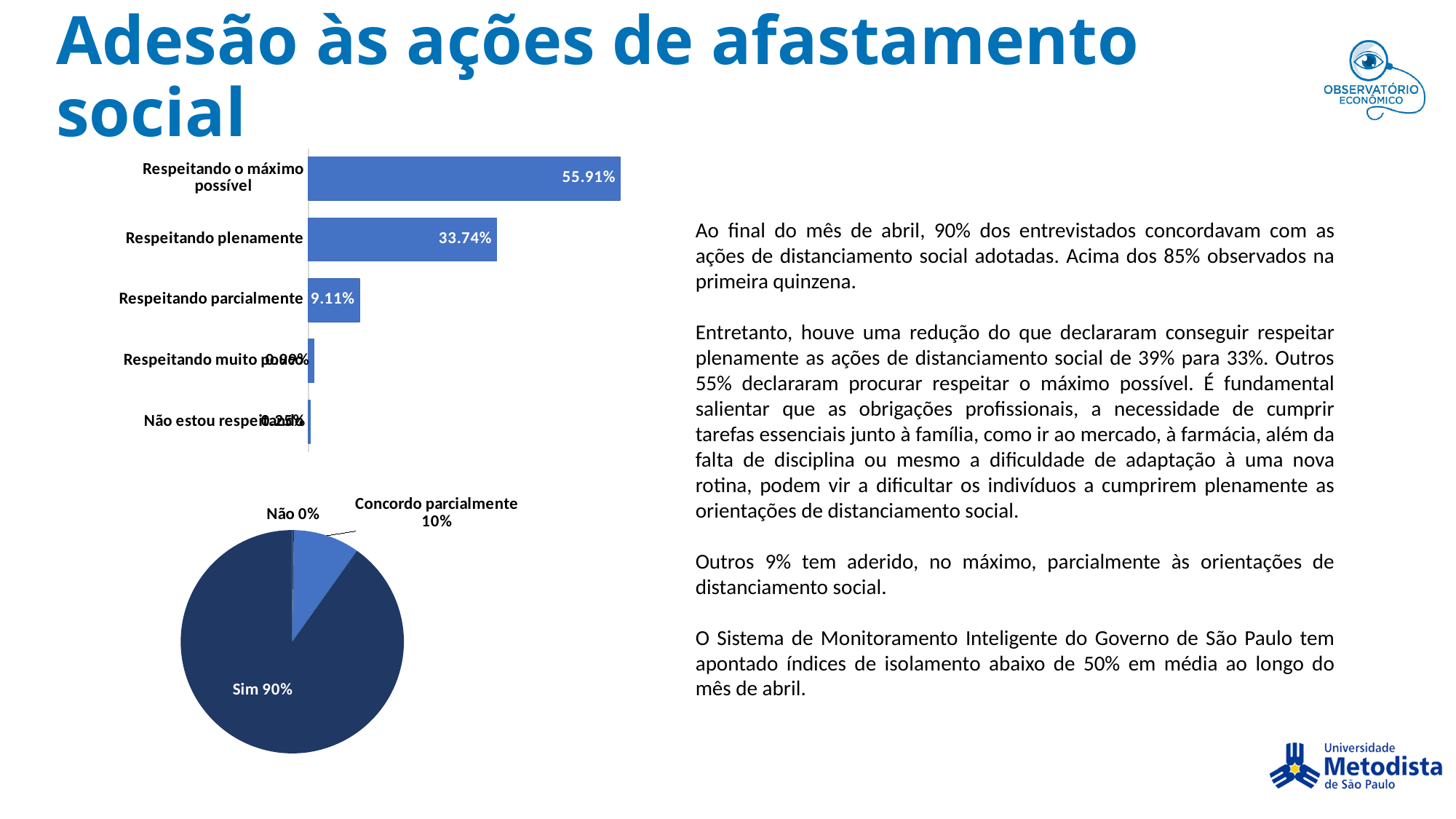
In the bar chart at the top left, what is the value for "Respeitando o máximo possível"? 55.91% In the pie chart at the bottom left, what share does "Concordo parcialmente" have? 10% In the bar chart at the top left, which is larger: "Respeitando plenamente" or "Respeitando parcialmente"? Respeitando plenamente What kind of chart is the chart at the bottom left of the slide? Pie chart What kind of chart is the chart at the top left of the slide? Bar chart In the bar chart at the top left, what is the difference between "Respeitando o máximo possível" and "Respeitando plenamente"? 22.17% In the pie chart at the bottom left, what share does "Sim" have? 90% In the bar chart at the top left, what is the value for "Respeitando plenamente"? 33.74% In the bar chart at the top left, which category has the highest value? Respeitando o máximo possível How many categories are shown in the bar chart at the top left? 5 In the pie chart at the bottom left, which slice is the largest? Sim In the bar chart at the top left, what is the value for "Respeitando parcialmente"? 9.11%